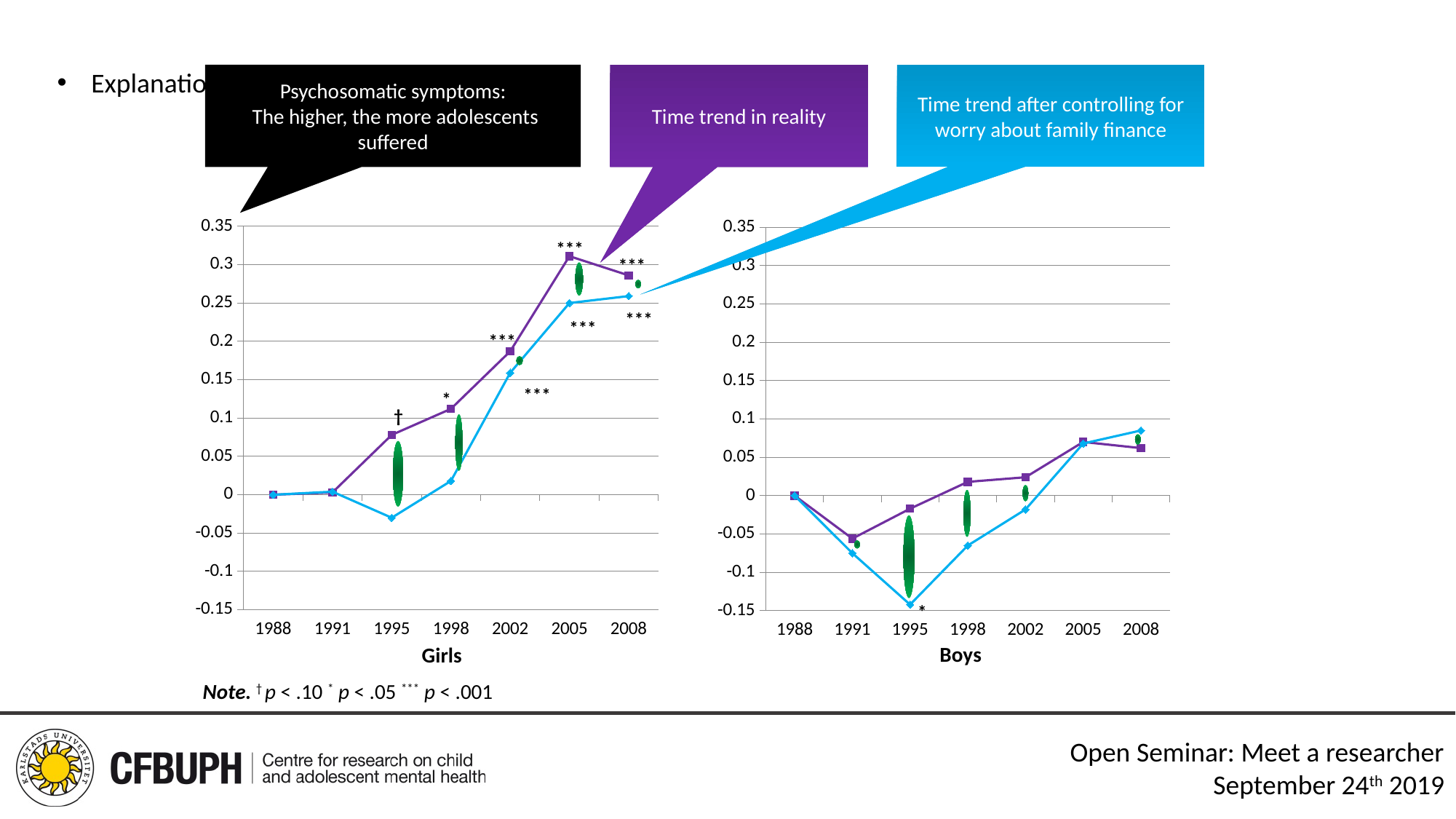
In the Boys chart, is the value of the blue line in 1995 greater or less than -0.1? less According to the callout, what does the blue line represent? Time trend after controlling for worry about family finance In the Girls chart, is the value of the purple line in 2002 greater or less than 0.15? greater In the Girls chart, is the value of the blue line in 2005 greater or less than 0.2? greater How many years are plotted on the x axis of the Boys chart? 7 In the Girls chart, does the purple line rise or fall from 1988 to 2005? rise In the Boys chart, which line has the larger value in 1995, the purple line or the blue line? the purple line What kind of chart is the Girls chart? line chart How many lines are plotted in the Girls chart? 2 In the Girls chart, in which year does the purple line reach its highest value? 2005 In the Girls chart, what is the value of the purple line in 1988? 0 In the Boys chart, in which year does the blue line reach its lowest value? 1995